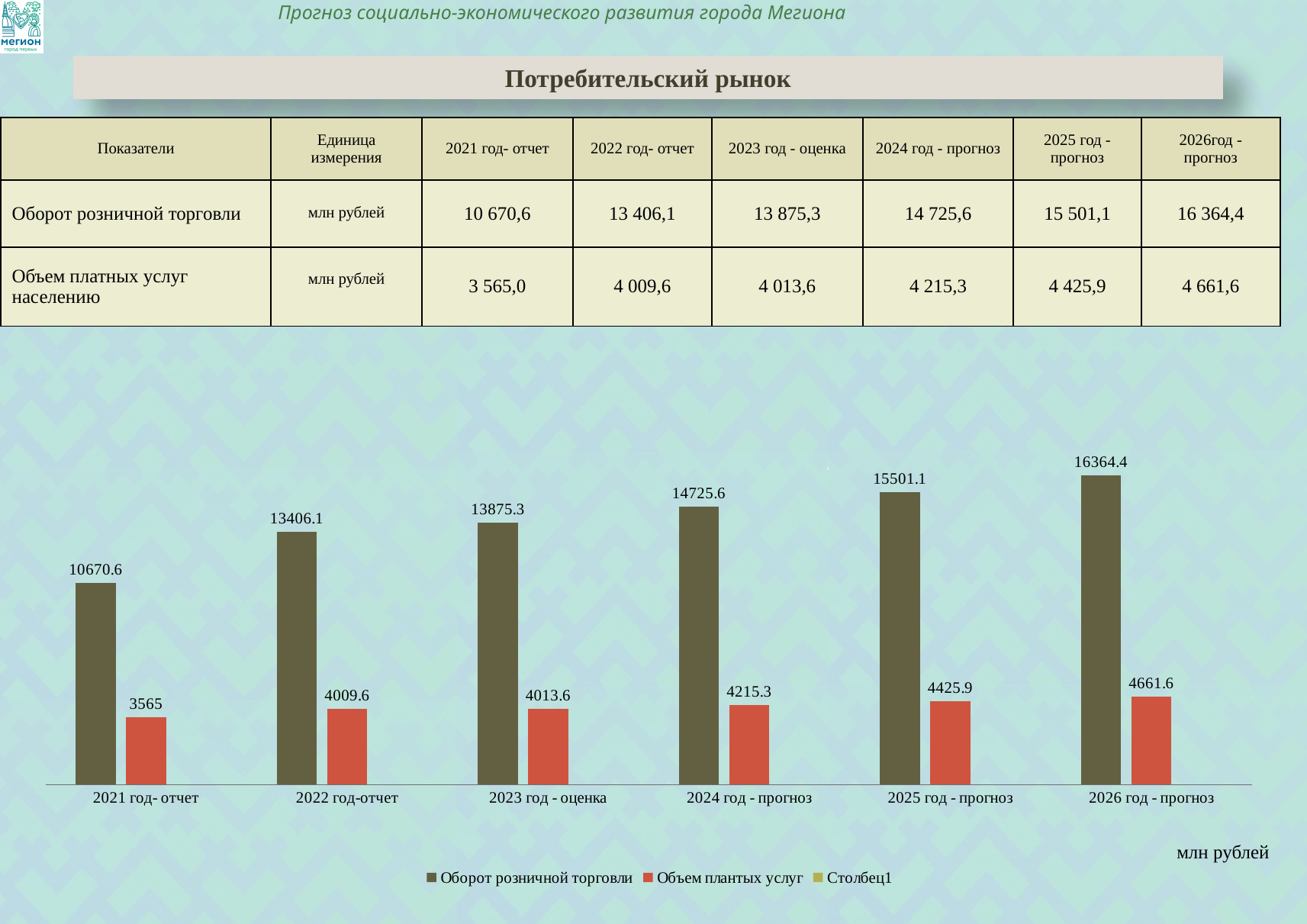
What type of chart is shown on the slide? bar chart How many series does the chart legend list? 3 How many year categories are shown on the x axis of the chart? 6 What is the value of Объем платных услуг for 2024 год - прогноз in the chart? 4215.3 What is the value of Оборот розничной торговли for 2023 год - оценка in the chart? 13875.3 Which year has the highest value for Оборот розничной торговли? 2026 год - прогноз Which is larger in 2025 год - прогноз: Оборот розничной торговли or Объем платных услуг? Оборот розничной торговли Does the value of Оборот розничной торговли rise or fall from 2021 to 2026? rise Which year has the lowest value for Объем платных услуг? 2021 год- отчет What is the value of Оборот розничной торговли for 2021 год- отчет in the chart? 10670.6 What is the difference between the Объем платных услуг values for 2026 год - прогноз and 2021 год- отчет? 1096.6 What is the difference between the Оборот розничной торговли values for 2026 год - прогноз and 2021 год- отчет? 5693.8